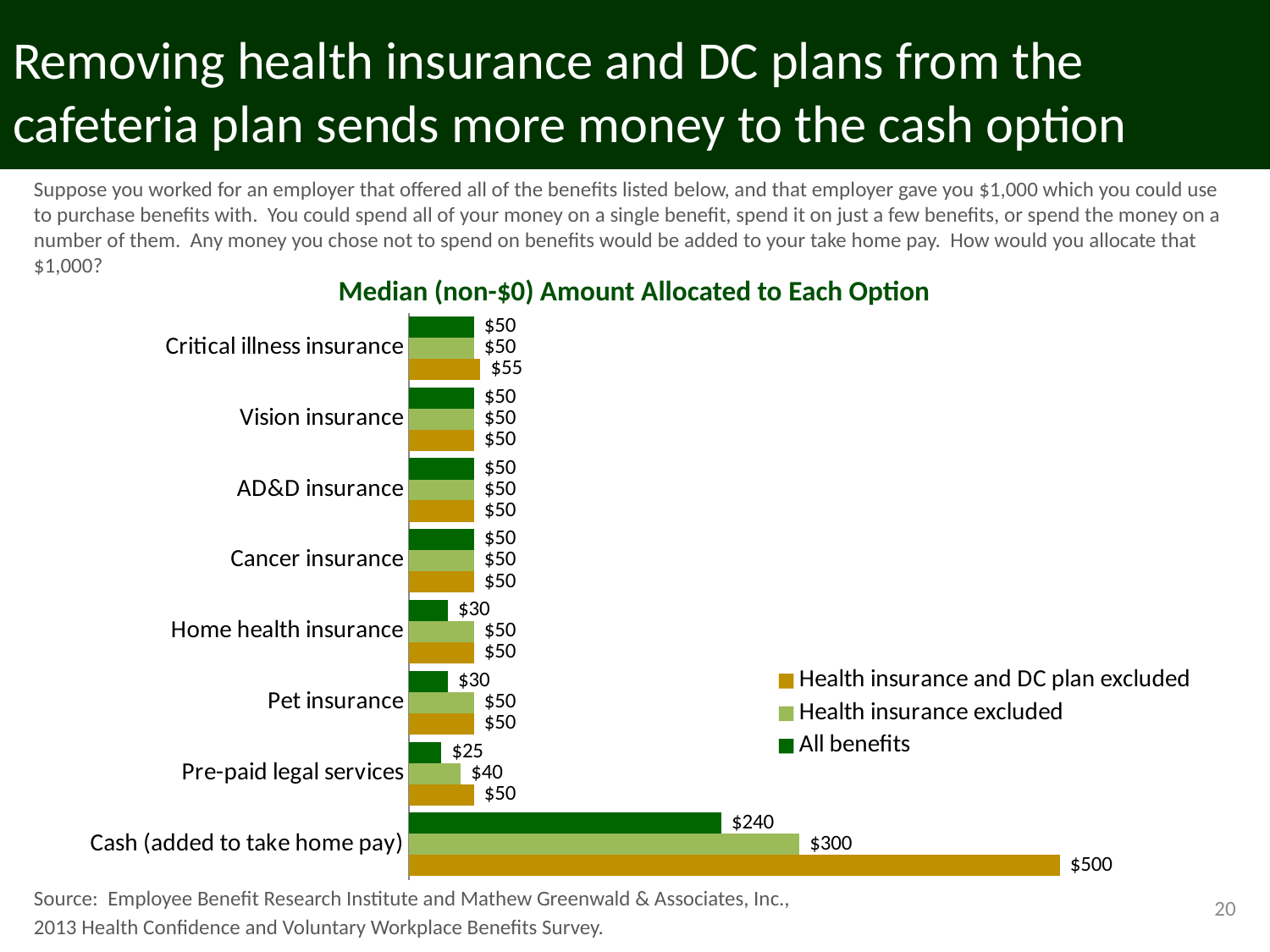
What is the median amount allocated to Pre-paid legal services when health insurance is excluded? $40 Which option has the highest median amount allocated in the All benefits series? Cash (added to take home pay) What type of chart is shown on the slide? Bar chart What is the title of the chart? Median (non-$0) Amount Allocated to Each Option What is the median amount allocated to Cash (added to take home pay) under the All benefits scenario? $240 How many series does the legend list? 3 Which option has the lowest median amount allocated in the All benefits series? Pre-paid legal services How many options (categories) are shown in the chart? 8 What is the median amount allocated to Critical illness insurance when health insurance and DC plan are excluded? $55 What is the median amount allocated to Cash (added to take home pay) when health insurance and DC plan are excluded? $500 What is the difference between the Cash (added to take home pay) amounts for the Health insurance and DC plan excluded series and the All benefits series? $260 For Pet insurance, which is larger: the All benefits amount or the Health insurance excluded amount? Health insurance excluded